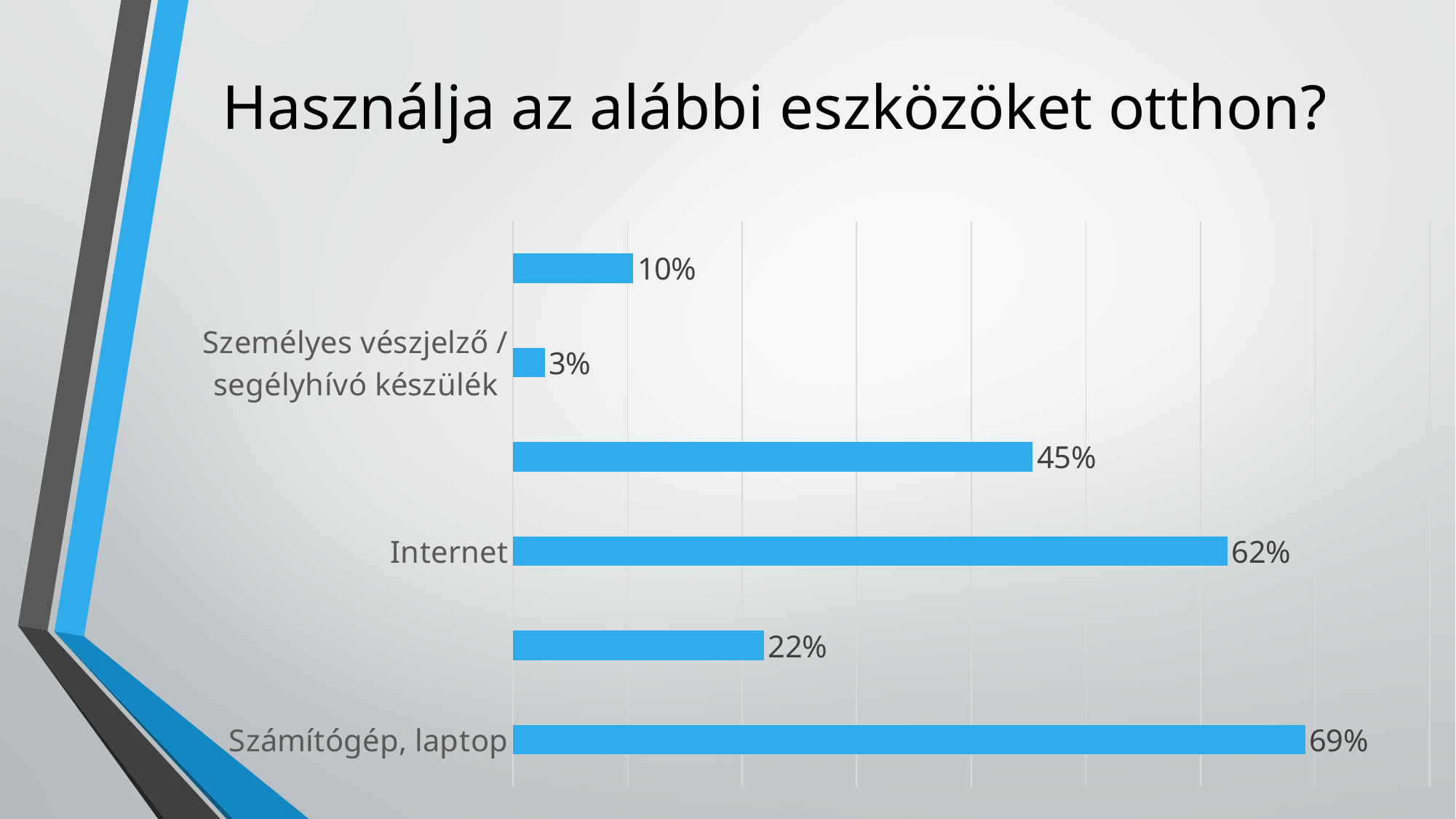
What colour are the bars in the chart? Blue What is the title of the slide? Használja az alábbi eszközöket otthon? Which category has the highest value? Számítógép, laptop Which category has the lowest value? Személyes vészjelző / segélyhívó készülék What is the value for Számítógép, laptop? 69% What kind of chart is shown on the slide? Bar chart What is the value for Internet? 62% Which is larger, the value for Internet or the value for Számítógép, laptop? Számítógép, laptop What is the value for Személyes vészjelző / segélyhívó készülék? 3% How many bars are plotted in the chart? 6 What is the difference between the values for Internet and Személyes vészjelző / segélyhívó készülék? 59 percentage points What is the difference between the values for Számítógép, laptop and Internet? 7 percentage points